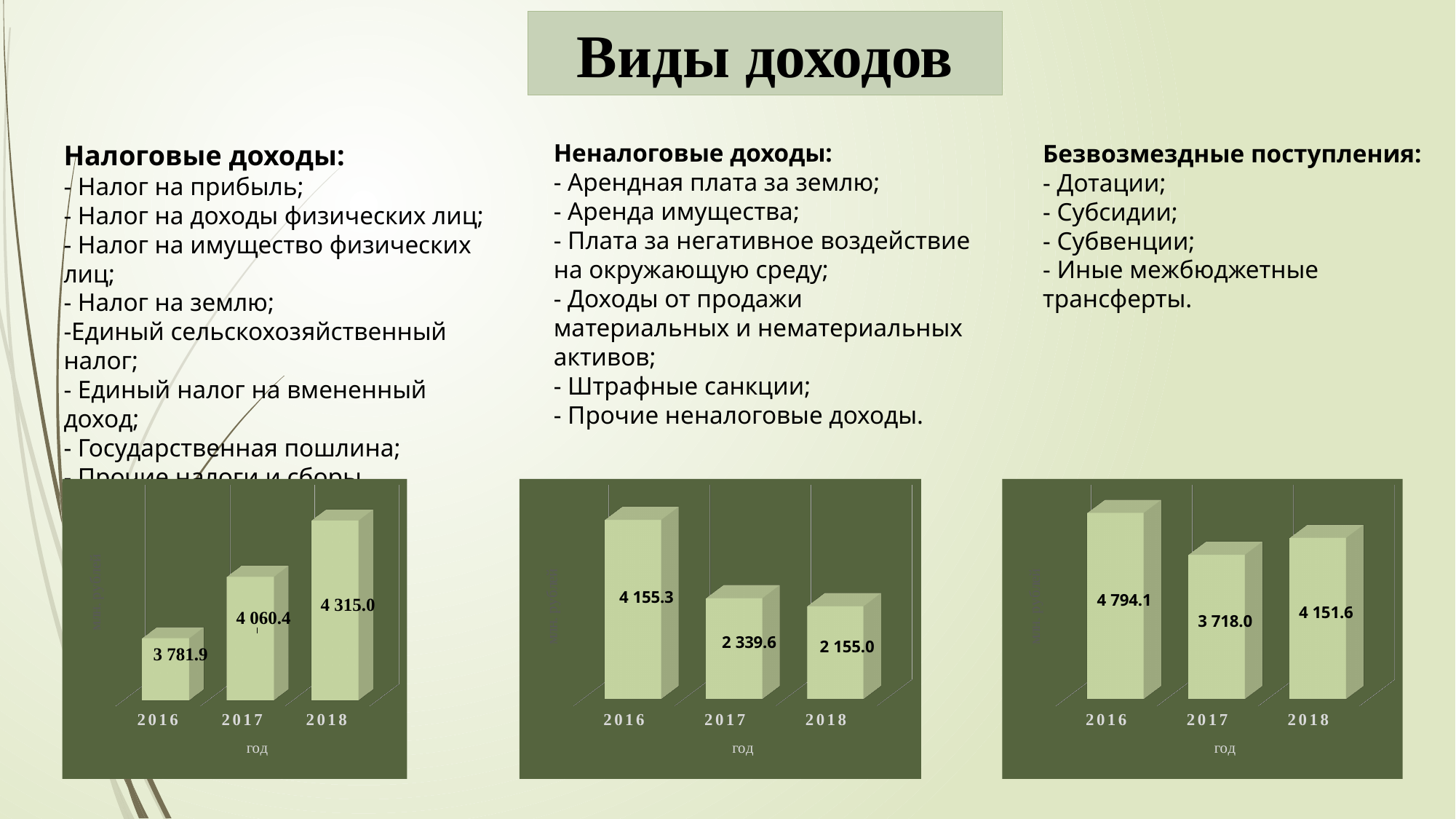
In the right chart, which is larger, the value for 2018 or the value for 2017? 2018 What kind of chart is the middle chart? bar chart How many bars does the left chart have? 3 In the middle chart, what is the difference between the 2016 and 2018 values? 2 000.3 Do the values in the left chart rise or fall from 2016 to 2018? rise In the middle chart, what is the value for 2017? 2 339.6 In the right chart, which year has the lowest value? 2017 In the left chart, what is the value for 2016? 3 781.9 In the left chart, what is the value for 2018? 4 315.0 In the right chart, what is the value for 2016? 4 794.1 In the left chart, what is the difference between the 2018 and 2016 values? 533.1 In the middle chart, which year has the highest value? 2016